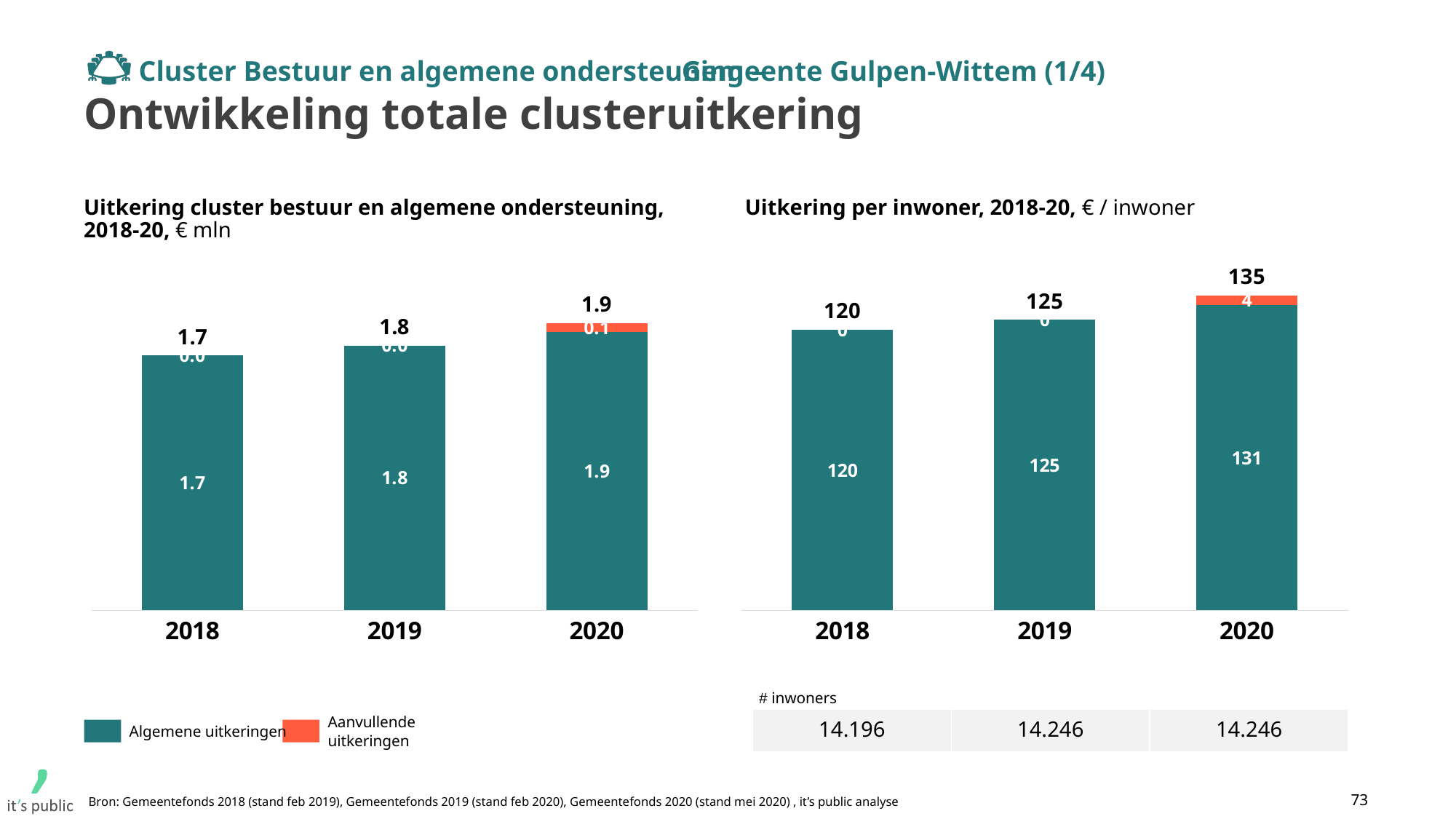
In the chart 'Uitkering per inwoner, 2018-20', what is the value of Aanvullende uitkeringen for 2020? 4 In the chart 'Uitkering per inwoner, 2018-20', what is the value of Algemene uitkeringen for 2020? 131 How many series does the legend on the slide list? 2 In the chart 'Uitkering per inwoner, 2018-20', is the Algemene uitkeringen value for 2019 larger or smaller than for 2018? larger In the left chart 'Uitkering cluster bestuur en algemene ondersteuning, 2018-20', which year has the lowest total value? 2018 In the left chart 'Uitkering cluster bestuur en algemene ondersteuning, 2018-20', what is the value of Aanvullende uitkeringen for 2020? 0.1 Do the total values in the chart 'Uitkering per inwoner, 2018-20' rise or fall from 2018 to 2020? rise How many years are shown on the x axis of the left chart 'Uitkering cluster bestuur en algemene ondersteuning, 2018-20'? 3 In the left chart 'Uitkering cluster bestuur en algemene ondersteuning, 2018-20', what is the total value for 2018? 1.7 In the chart 'Uitkering per inwoner, 2018-20', what is the total value for 2020? 135 In the chart 'Uitkering per inwoner, 2018-20', which year has the highest total value? 2020 In the chart 'Uitkering per inwoner, 2018-20', what is the difference between the total values for 2020 and 2018? 15